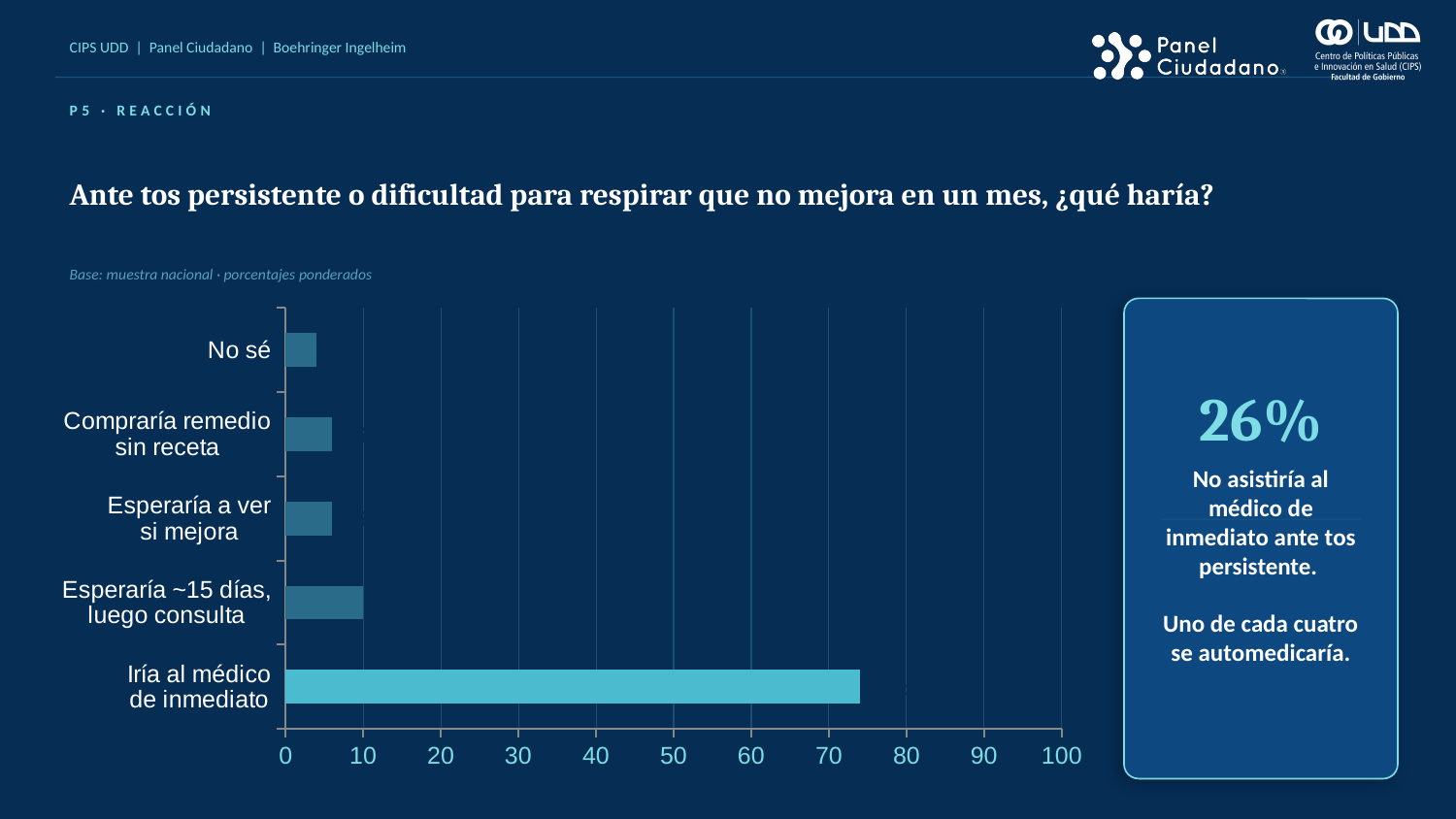
Is the value for "No sé" greater or less than 10? less Is the value for "Iría al médico de inmediato" greater or less than 80? less Is the value for "Compraría remedio sin receta" greater or less than 10? less How many categories are plotted in the chart? 5 What kind of chart is shown on the slide? bar chart What is the maximum value shown on the chart's horizontal axis? 100 Which category has the highest value in the chart? Iría al médico de inmediato Which is larger: the value for "Esperaría ~15 días, luego consulta" or the value for "No sé"? Esperaría ~15 días, luego consulta What is the title of the chart on the slide? Ante tos persistente o dificultad para respirar que no mejora en un mes, ¿qué haría? Which category has the lowest value in the chart? No sé